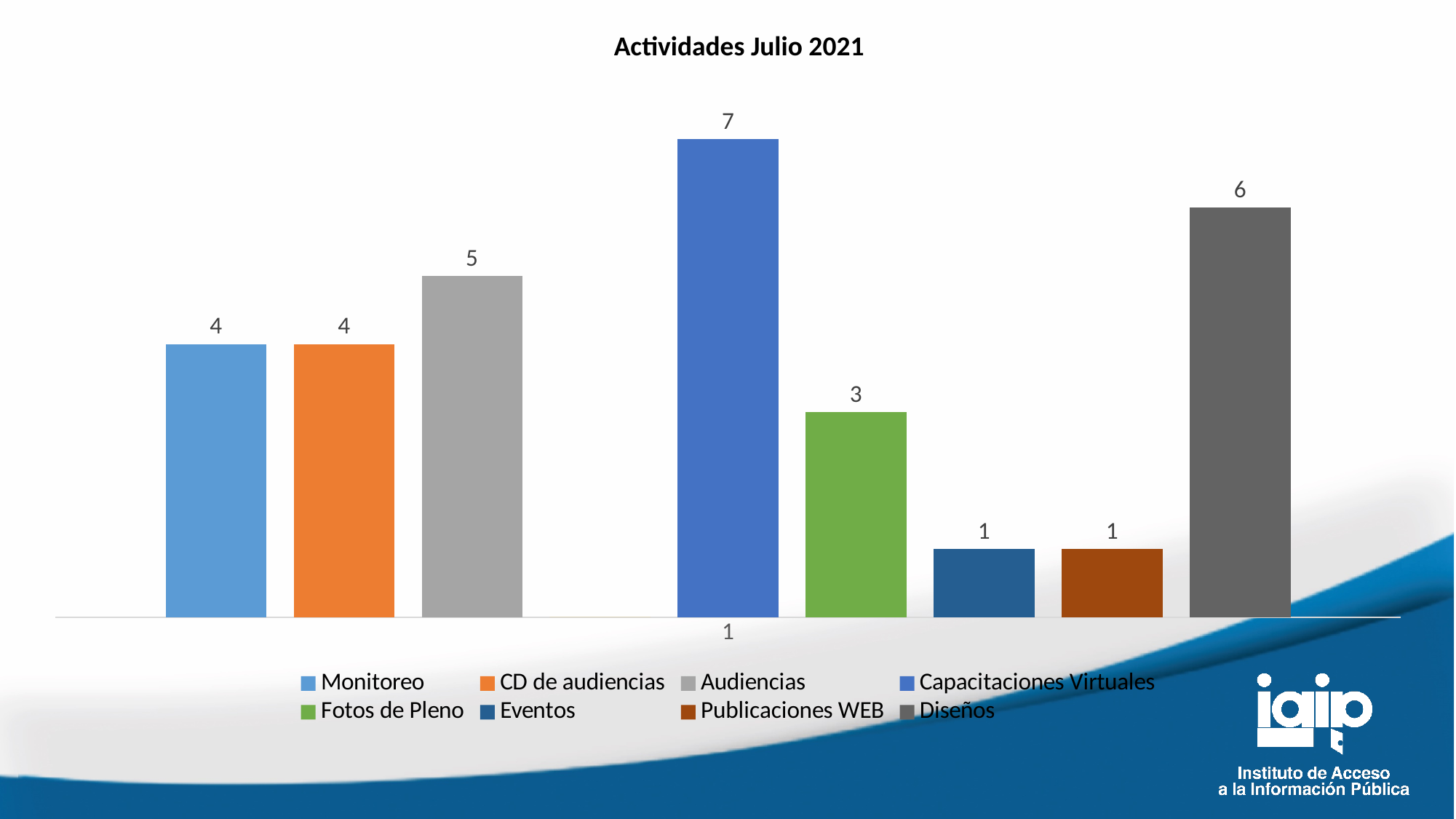
What is the value for Diseños? 6 What is the value for Capacitaciones Virtuales? 7 What is the value for Fotos de Pleno? 3 What is the difference between the values for Diseños and Fotos de Pleno? 3 What is the difference between the values for Capacitaciones Virtuales and Diseños? 1 What is the title of the chart? Actividades Julio 2021 How many series does the legend list? 8 Which is larger, the value for Audiencias or the value for Monitoreo? Audiencias What type of chart is shown on the slide? bar chart What is the value for Publicaciones WEB? 1 What is the value for Audiencias? 5 Which series has the highest value? Capacitaciones Virtuales